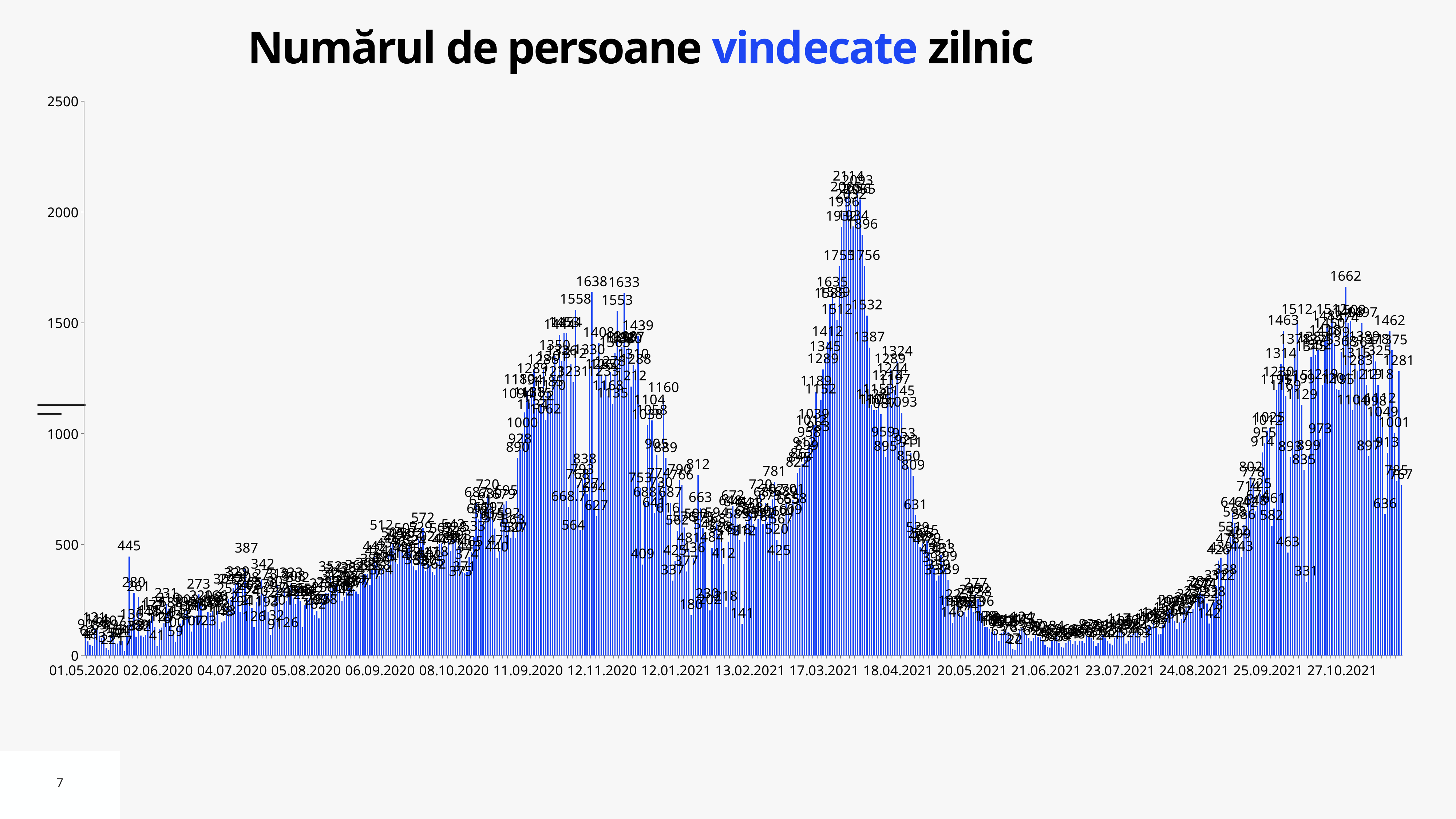
Which is larger, the peak value around 17.03.2021 (2114) or the peak value around 27.10.2021 (1662)? 2114 Do the values rise or fall between 18.04.2021 and 21.06.2021? fall What is the value of the tallest bar in the peak around 27.10.2021? 1662 Is the highest bar around 17.03.2021 greater or less than 2000? greater What kind of chart is shown on the slide? bar chart What is the highest daily value labelled on the chart? 2114 What is the value of the tall bar labelled near 04.07.2020? 387 What is the highest value shown on the vertical axis? 2500 What is the title of the chart? Numărul de persoane vindecate zilnic What is the difference between the peak value 2114 and the peak value 1662? 452 Are the bars around 21.06.2021 greater or less than 500? less